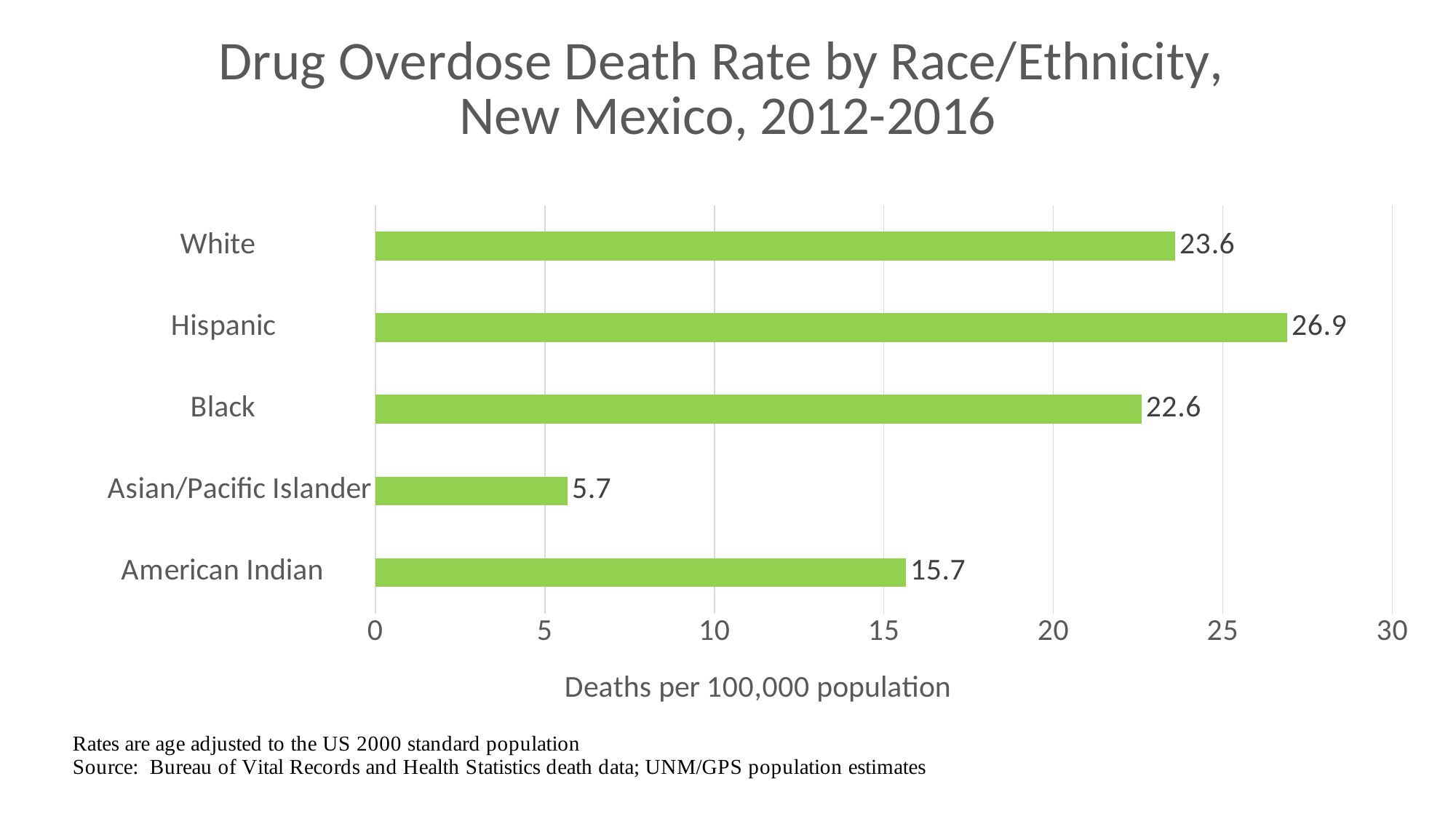
How many race/ethnicity groups are shown in the chart? 5 Which race/ethnicity group has the highest drug overdose death rate? Hispanic What is the drug overdose death rate for Hispanic residents? 26.9 Which group has a higher drug overdose death rate, Black or American Indian? Black Is the death rate for American Indian residents greater or less than 20? less What is the drug overdose death rate for Asian/Pacific Islander residents? 5.7 Which race/ethnicity group has the lowest drug overdose death rate? Asian/Pacific Islander What kind of chart is shown on the slide? Bar chart What is the label of the horizontal axis? Deaths per 100,000 population What is the difference between the death rates for Hispanic and White residents? 3.3 What is the difference between the death rates for White and Black residents? 1.0 What is the drug overdose death rate for American Indian residents? 15.7